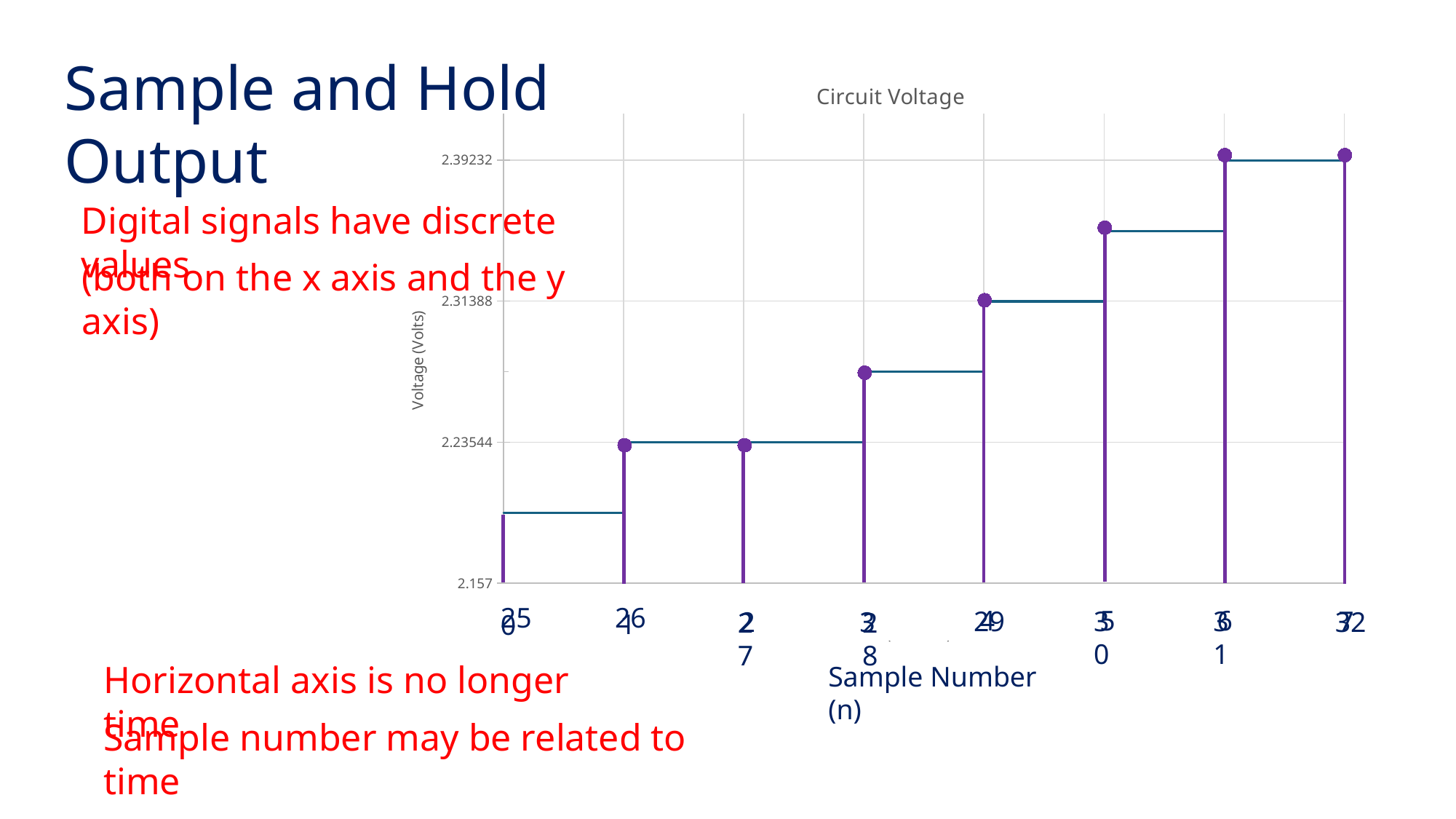
What is the difference between the voltage at sample number 31 and the voltage at sample number 26? 0.15688 Is the voltage at sample number 28 greater or less than 2.31388? less Which sample number has the lowest voltage? 25 Is the voltage at sample number 30 greater or less than 2.31388? greater What is the voltage at sample number 32? 2.39232 What is the voltage at sample number 26? 2.23544 What is the label of the vertical axis? Voltage (Volts) What is the title of the chart? Circuit Voltage Do the voltage values rise or fall as the sample number increases? rise What is the voltage at sample number 29? 2.31388 Which has the higher voltage, sample number 27 or sample number 29? 29 Is the voltage at sample number 25 greater or less than 2.23544? less